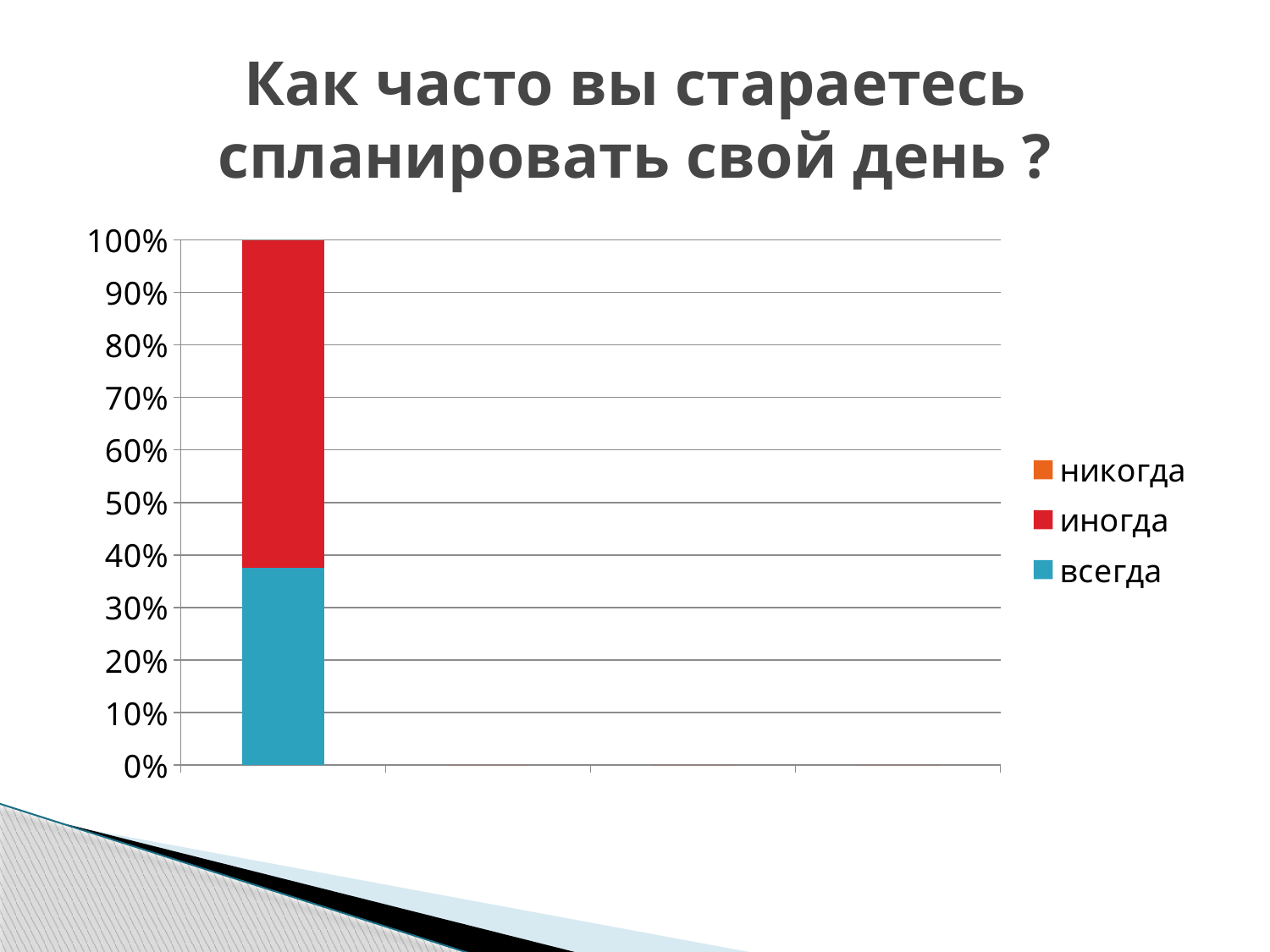
Is the value for иногда greater or less than 50%? greater Is the value for никогда greater or less than 10%? less Which legend entry is shown in blue? всегда What kind of chart is shown on the slide? bar chart Which series takes up the largest share of the stacked bar? иногда How many series does the legend list? 3 What is the title of the chart? Как часто вы стараетесь спланировать свой день ? What is the total height of the stacked bar? 100% Is the value for всегда greater or less than 30%? greater Which is larger in the stacked bar, иногда or всегда? иногда